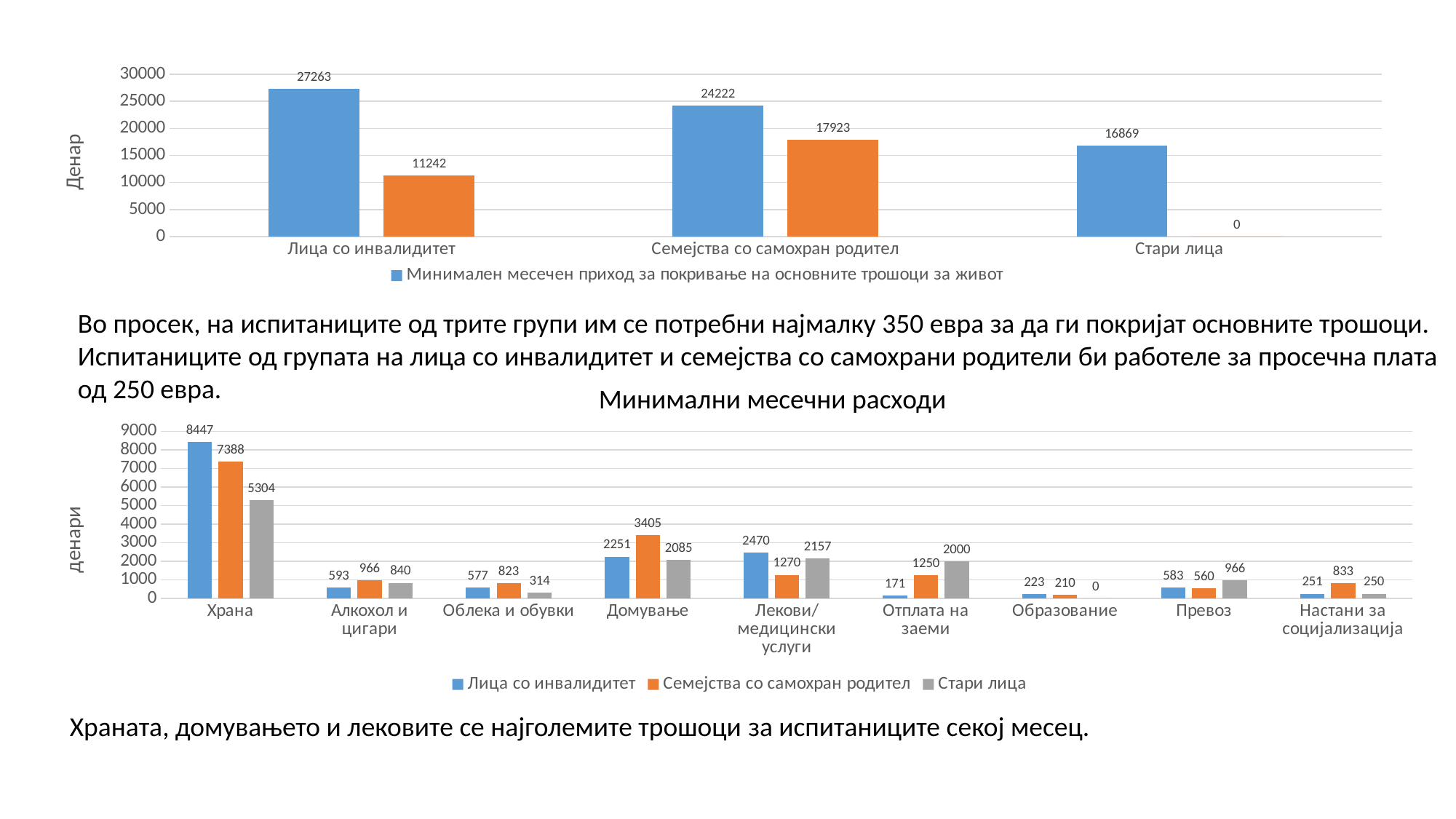
In the top chart, what is the value of the orange bar for Семејства со самохран родител? 17923 In the chart titled Минимални месечни расходи, what is the value for Стари лица in the Храна category? 5304 In the top chart, which category has the highest blue bar? Лица со инвалидитет In the chart titled Минимални месечни расходи, which category has the highest value for Лица со инвалидитет? Храна In the top chart, what is the value of the blue bar for Лица со инвалидитет? 27263 In the top chart, what is the difference between the blue and orange bars for Лица со инвалидитет? 16021 In the chart titled Минимални месечни расходи, what is the value for Семејства со самохран родител in the Домување category? 3405 What type of chart is the chart titled Минимални месечни расходи? Bar chart In the chart titled Минимални месечни расходи, which is larger for Лекови/медицински услуги: Лица со инвалидитет or Стари лица? Лица со инвалидитет In the top chart, how many categories are shown on the x axis? 3 In the chart titled Минимални месечни расходи, what is the difference between Семејства со самохран родител and Стари лица for Отплата на заеми? 750 In the chart titled Минимални месечни расходи, how many series does the legend list? 3